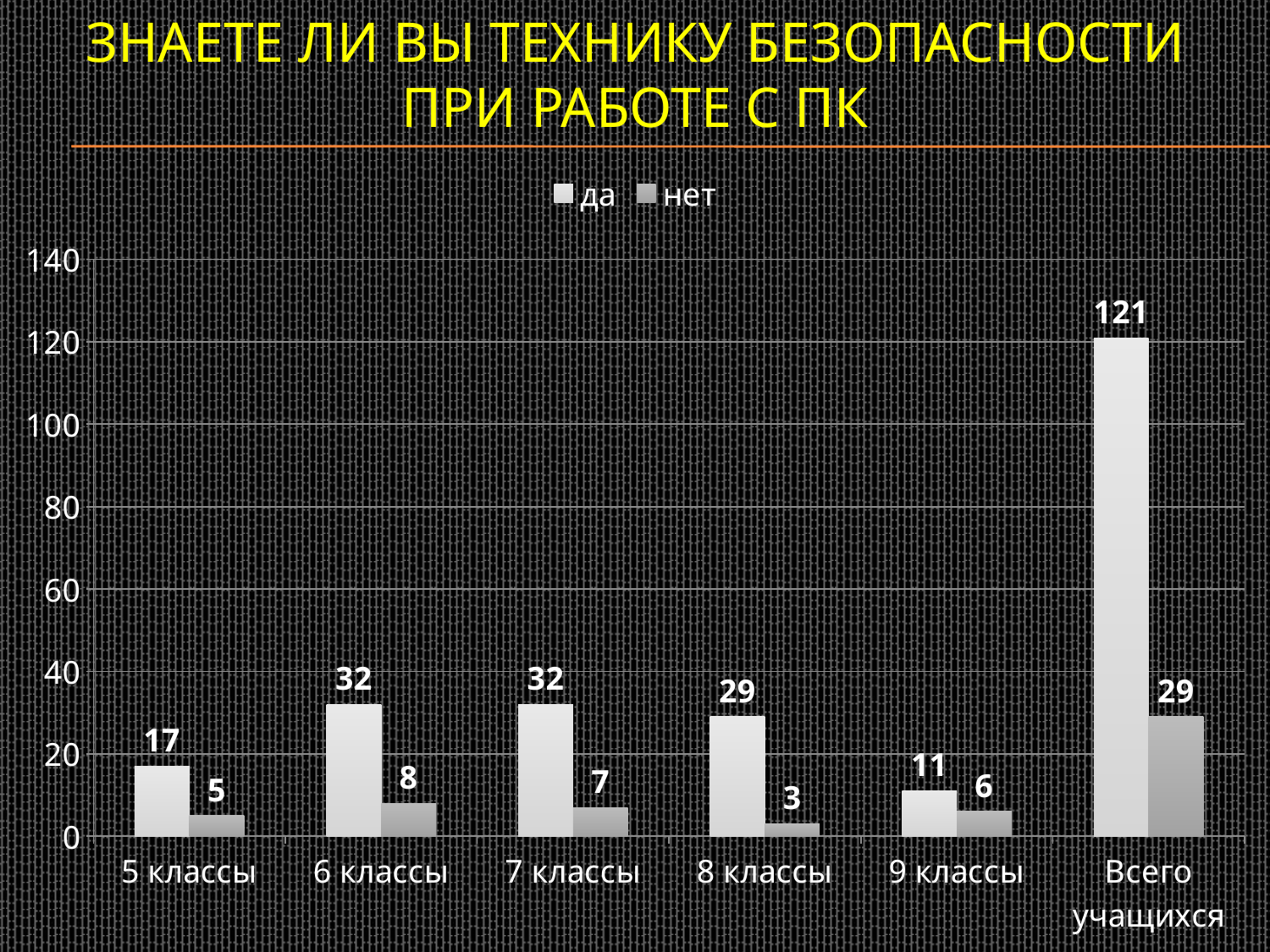
How many series does the legend list? 2 What is the value for "да" in the "7 классы" category? 32 What kind of chart is shown on the slide? bar chart Among the class categories (5 to 9 классы), which has the lowest value for "да"? 9 классы What are the two series names listed in the legend? да, нет How many categories are shown on the x axis? 6 Among the class categories (5 to 9 классы), which has the highest value for "нет"? 6 классы What is the value for "да" in the "Всего учащихся" category? 121 Is the value for "да" in "Всего учащихся" greater or less than 100? greater What is the value for "нет" in the "8 классы" category? 3 What is the difference between the "да" and "нет" values for "5 классы"? 12 Which is larger: the "нет" value for "6 классы" or the "нет" value for "9 классы"? 6 классы